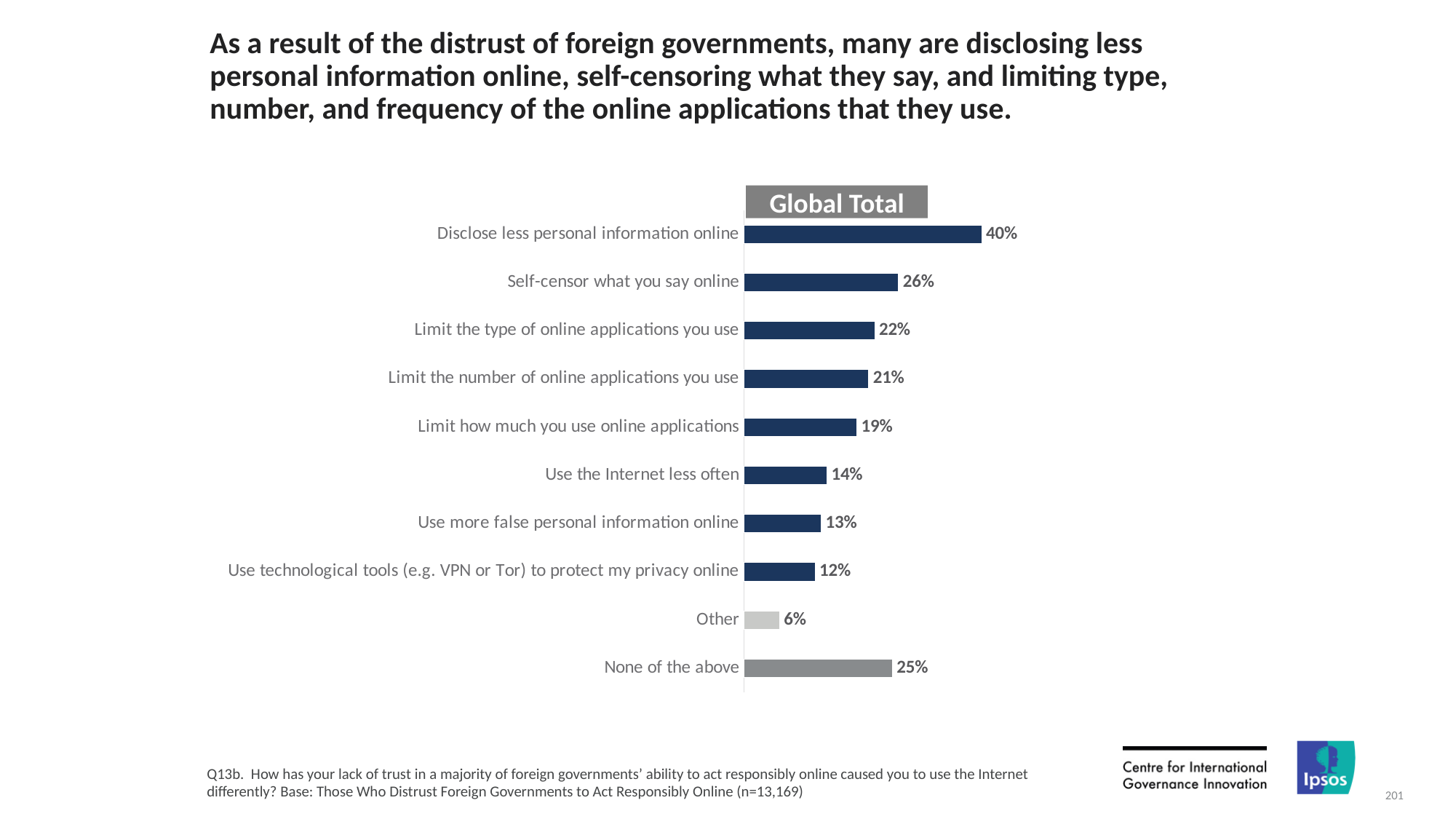
What is the title shown above the chart bars? Global Total What is the difference between "Use the Internet less often" and "Other"? 8% Which is larger: "Limit how much you use online applications" or "None of the above"? None of the above How many categories are shown in the chart? 10 What kind of chart is shown on the slide? Bar chart What is the value for "Use technological tools (e.g. VPN or Tor) to protect my privacy online"? 12% What is the value for "Disclose less personal information online"? 40% What is the value for "None of the above"? 25% Which category has the highest value? Disclose less personal information online What is the value for "Self-censor what you say online"? 26% Which category has the lowest value? Other What is the difference between "Disclose less personal information online" and "Self-censor what you say online"? 14%